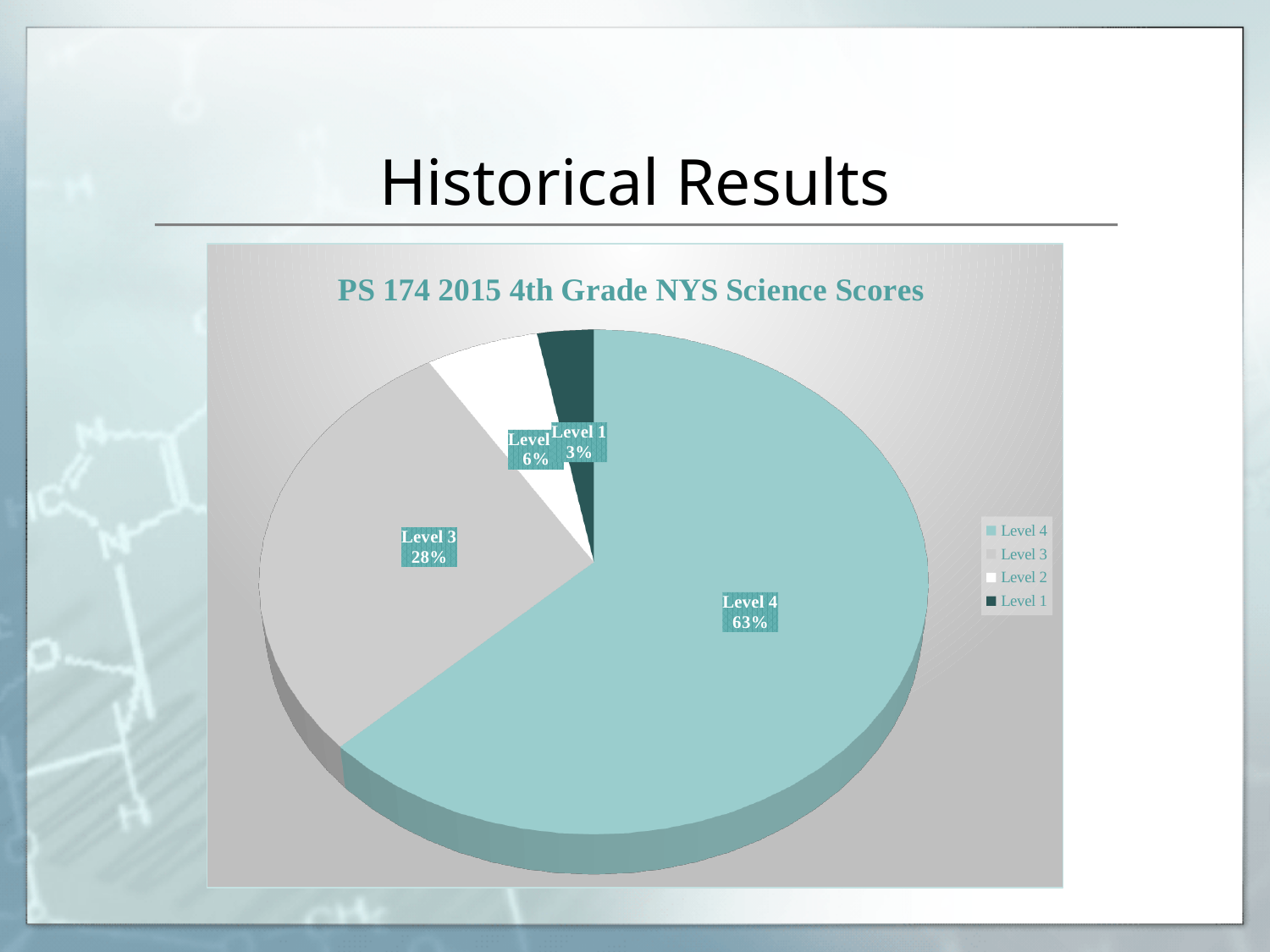
What is the title of the chart? PS 174 2015 4th Grade NYS Science Scores What kind of chart is shown on the slide? pie chart What percentage of students scored at Level 4? 63% Which level has the largest share of the pie? Level 4 What percentage of students scored at Level 3? 28% Which level has the smallest share of the pie? Level 1 What is the difference in percentage points between Level 4 and Level 3? 35 What percentage of students scored at Level 2? 6% Which is larger, the share for Level 2 or the share for Level 1? Level 2 How many entries does the legend list? 4 How many slices does the pie chart have? 4 What percentage of students scored at Level 1? 3%